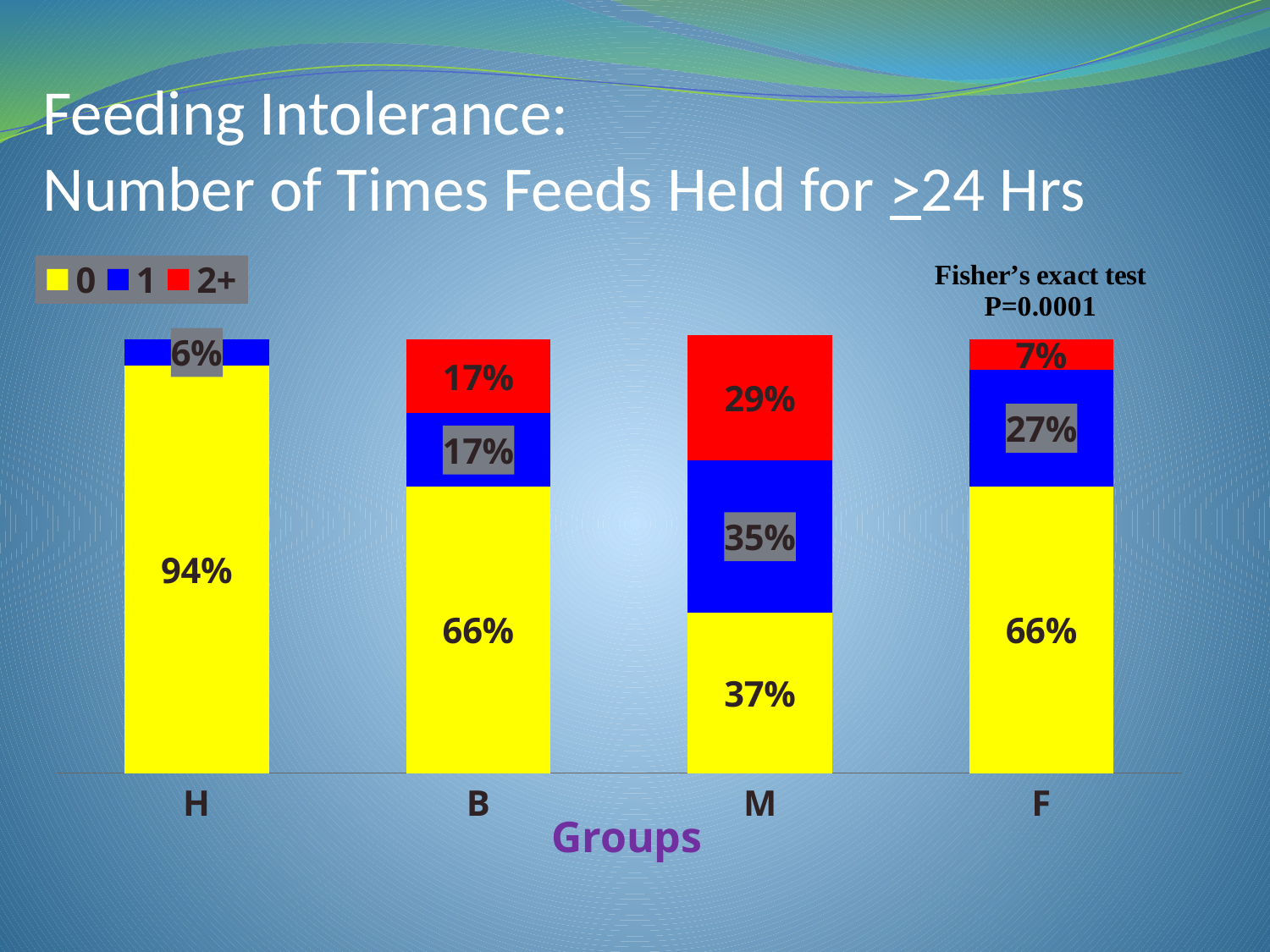
What is the difference between the '0' values for groups H and M? 57% Which group has the highest value for the '0' series? H Which group has the highest value for the '2+' series? M How many series does the legend list? 3 What percentage of group H had feeds held 0 times? 94% How many groups are shown on the x axis? 4 What is the value of the '2+' series for group B? 17% Which group has the lowest value for the '0' series? M What type of chart is shown on the slide? Stacked bar chart What is the value of the '2+' series for group F? 7% Which is larger, the '1' value for group F or the '1' value for group B? F What is the value of the '1' series for group M? 35%